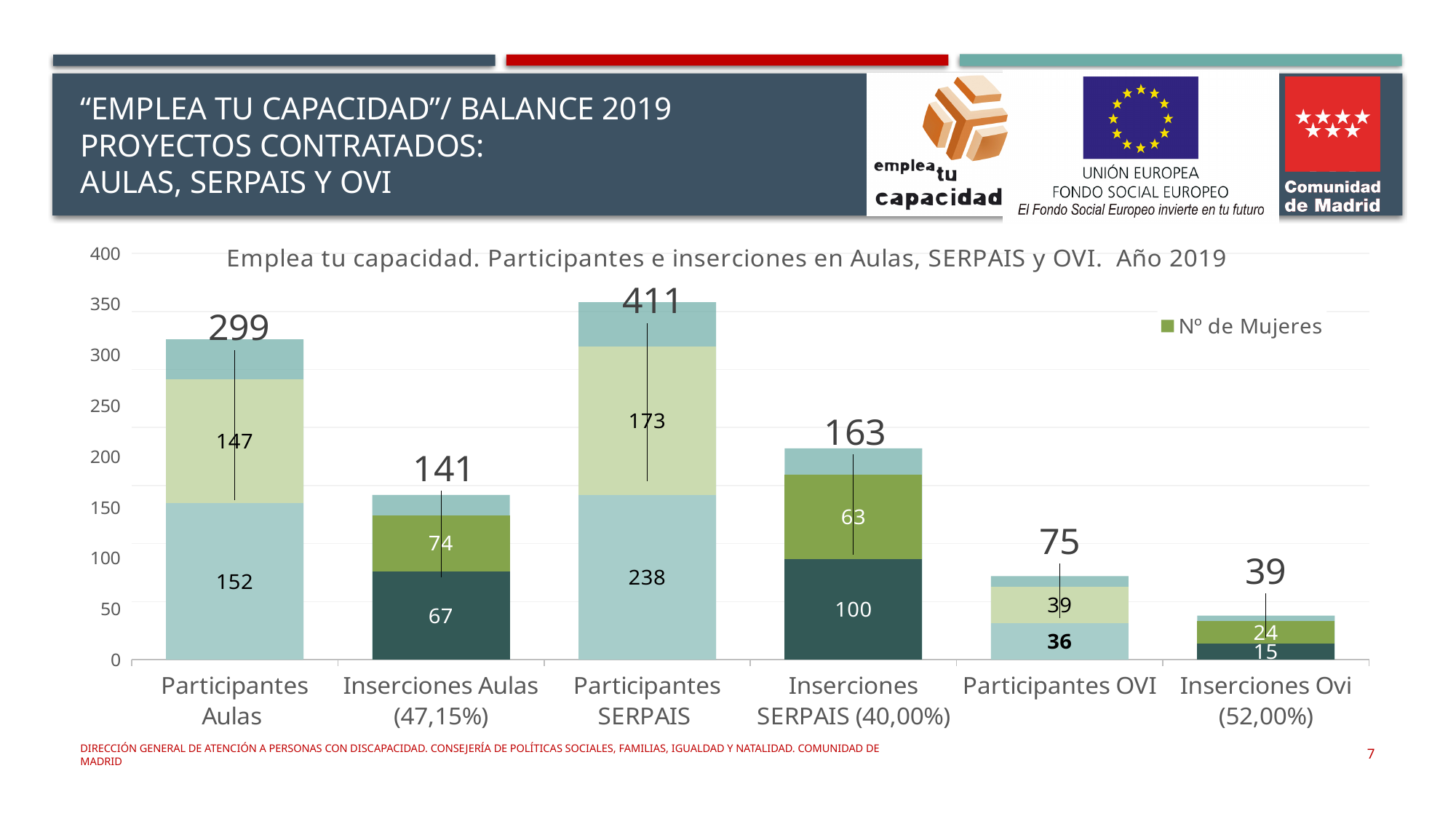
What is the difference between the totals for Participantes SERPAIS and Participantes Aulas? 112 What is the Nº de Mujeres value for Inserciones Aulas (47,15%)? 74 Which is larger, the total for Inserciones SERPAIS (40,00%) or the total for Inserciones Aulas (47,15%)? Inserciones SERPAIS (40,00%) What is the total value shown above the Participantes Aulas bar? 299 What is the total value shown above the Participantes SERPAIS bar? 411 What is the Nº de Mujeres value for Inserciones SERPAIS (40,00%)? 63 How many categories are shown on the x axis? 6 What is the lower segment value for Inserciones Ovi (52,00%)? 15 What kind of chart is shown on the slide? Stacked bar chart Which category has the highest total value? Participantes SERPAIS What is the title of the chart? Emplea tu capacidad. Participantes e inserciones en Aulas, SERPAIS y OVI. Año 2019 Which category has the lowest total value? Inserciones Ovi (52,00%)